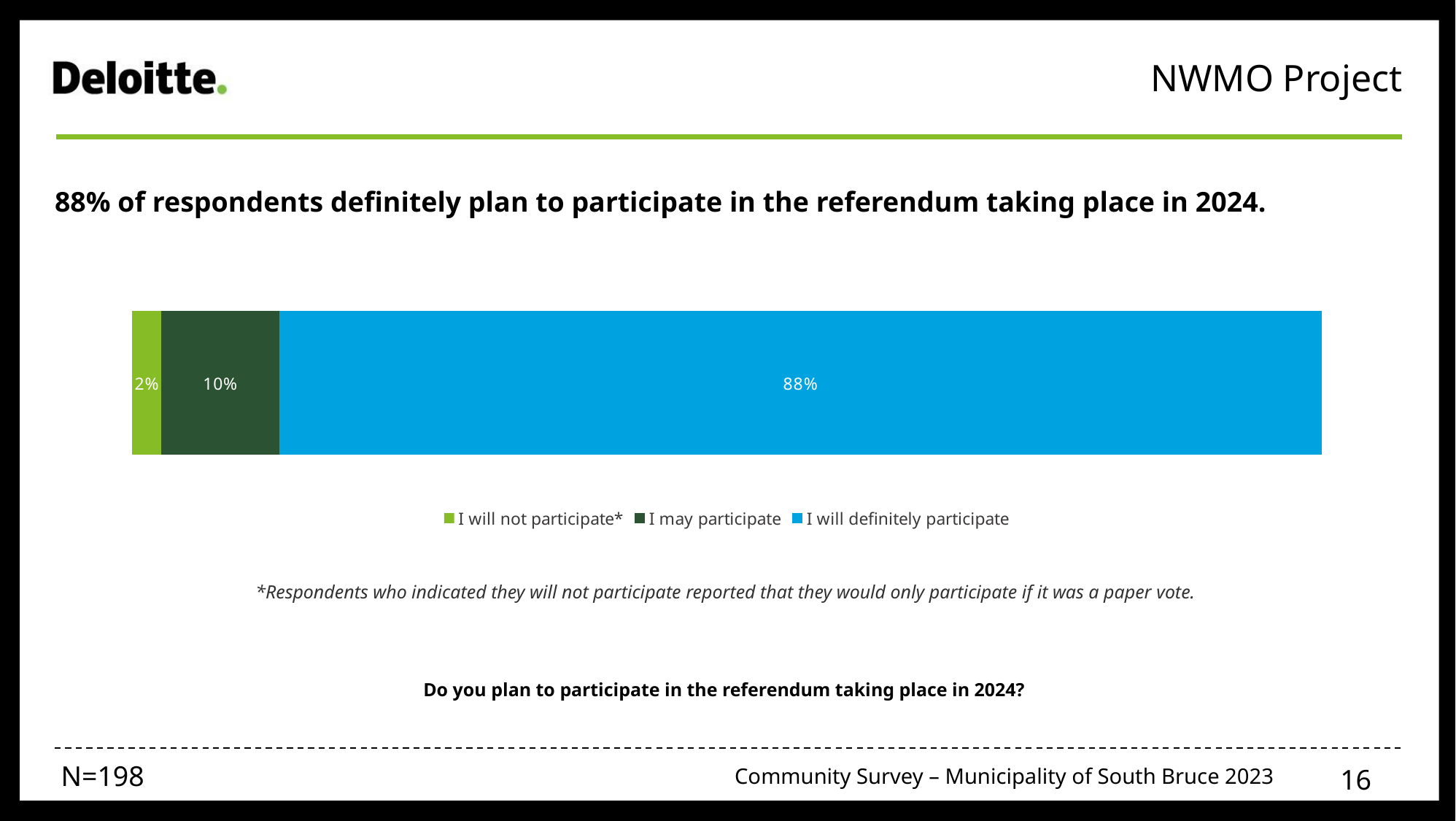
What colour is the segment for "I will definitely participate"? Blue What is the difference in percentage points between "I may participate" and "I will not participate"? 8 How many series does the legend list? 3 What percentage of respondents said "I may participate"? 10% Which is larger: the share for "I may participate" or the share for "I will not participate"? I may participate Which response has the smallest share of respondents? I will not participate Which response has the largest share of respondents? I will definitely participate What percentage of respondents said "I will definitely participate"? 88% What is the total of the three segments in the stacked bar? 100% What percentage of respondents said "I will not participate"? 2% What kind of chart is shown on the slide? Stacked bar chart What is the difference in percentage points between "I will definitely participate" and "I may participate"? 78